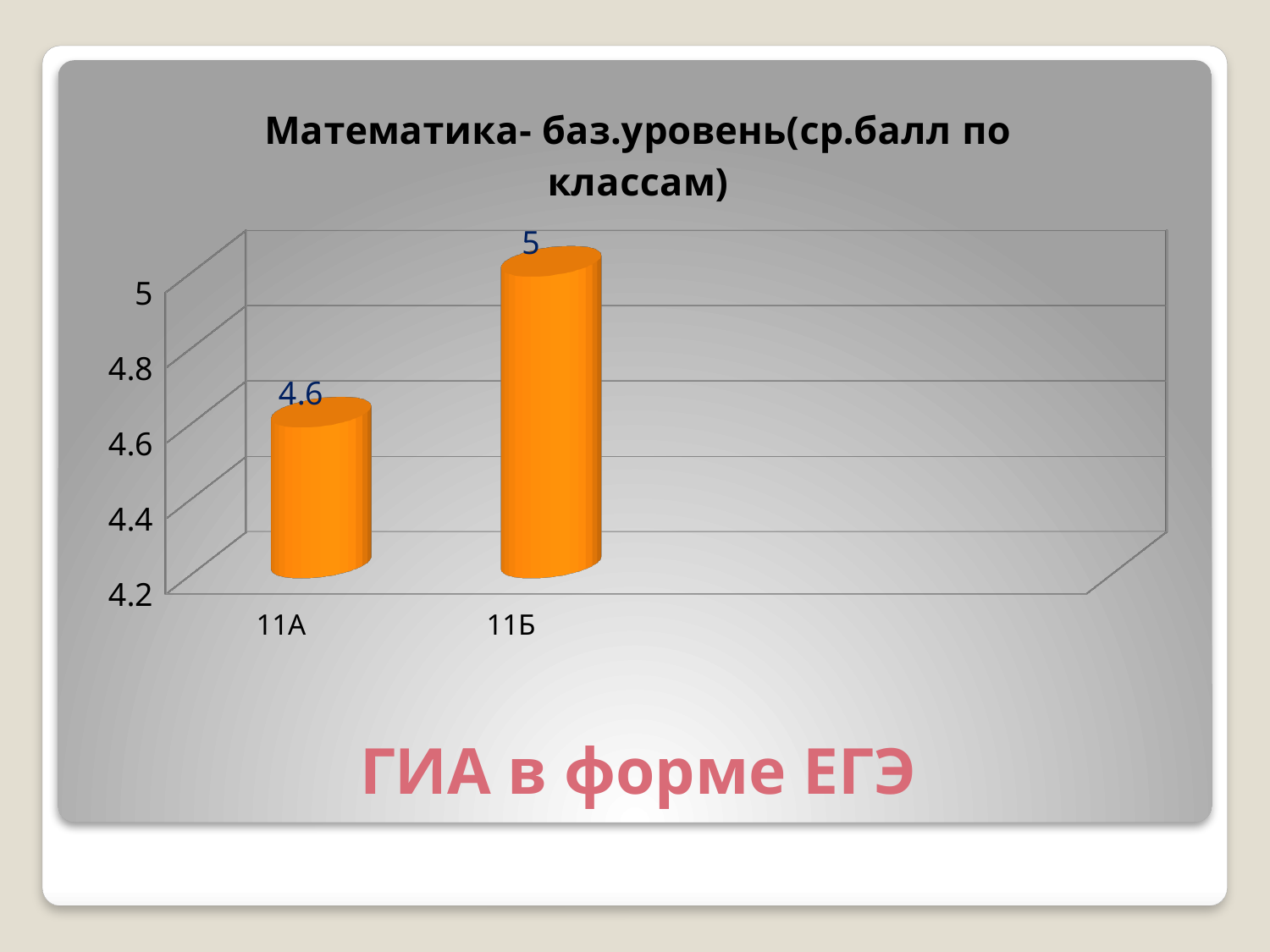
What colour are the bars on the chart? orange Which class has the highest average score? 11Б What is the title of the chart? Математика- баз.уровень(ср.балл по классам) What is the value for 11А? 4.6 Do the values rise or fall from 11А to 11Б? rise Which class has the lowest average score? 11А How many classes are shown on the chart? 2 What kind of chart is shown on the slide? bar chart What is the value for 11Б? 5 Which is larger, the value for 11А or the value for 11Б? 11Б Is the value for 11А greater or less than 4.8? less What is the difference between the values for 11Б and 11А? 0.4